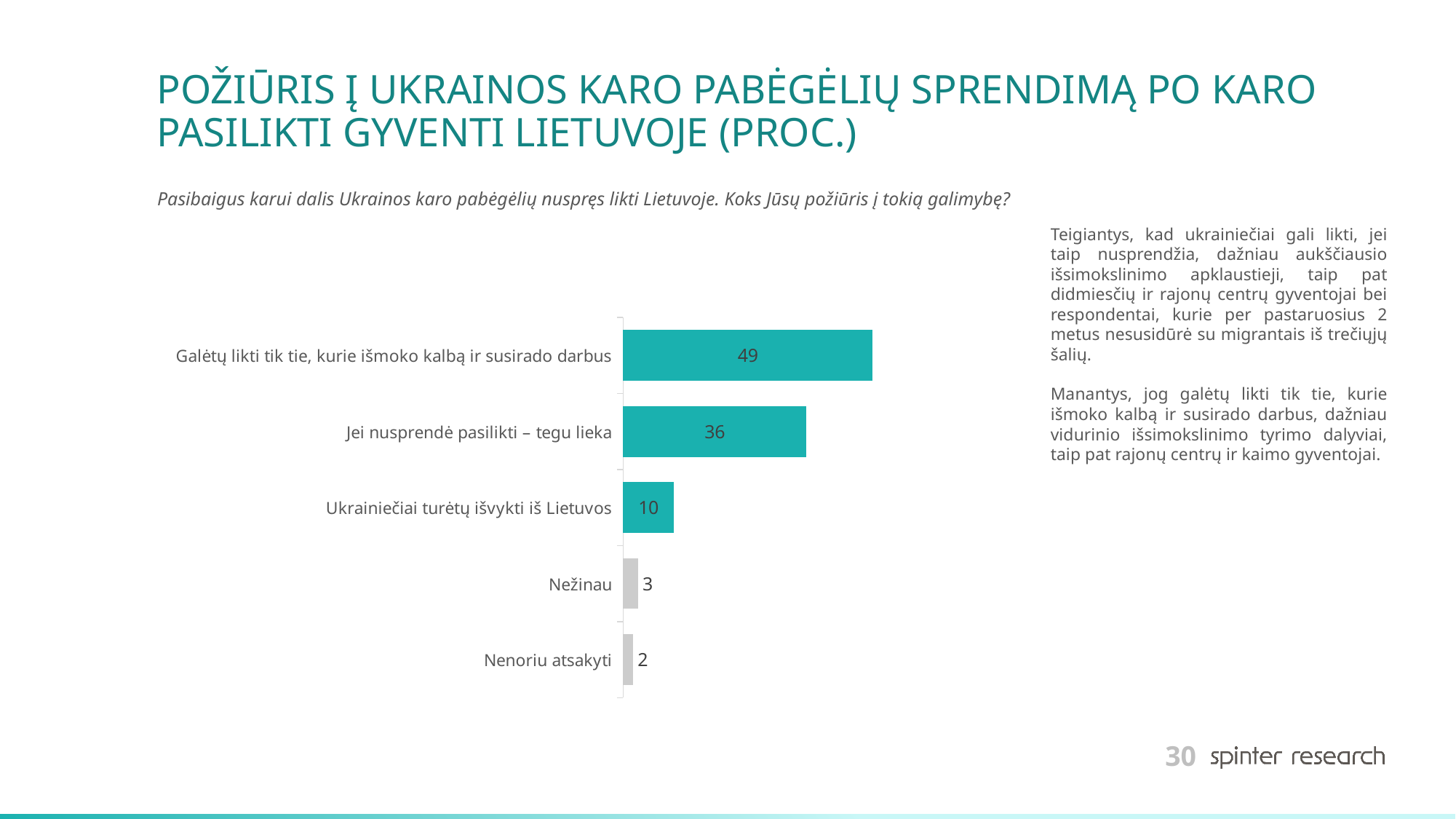
Which is larger: the value for "Ukrainiečiai turėtų išvykti iš Lietuvos" or the value for "Nežinau"? Ukrainiečiai turėtų išvykti iš Lietuvos What is the value for "Nenoriu atsakyti"? 2 What kind of chart is shown on the slide? Bar chart What is the value for "Nežinau"? 3 What is the value for "Ukrainiečiai turėtų išvykti iš Lietuvos"? 10 What is the value for "Galėtų likti tik tie, kurie išmoko kalbą ir susirado darbus"? 49 Which category has the lowest value? Nenoriu atsakyti How many categories are shown in the chart? 5 What is the difference between the values for "Galėtų likti tik tie, kurie išmoko kalbą ir susirado darbus" and "Jei nusprendė pasilikti – tegu lieka"? 13 How many bars are coloured grey rather than teal? 2 What is the value for "Jei nusprendė pasilikti – tegu lieka"? 36 Which category has the highest value? Galėtų likti tik tie, kurie išmoko kalbą ir susirado darbus